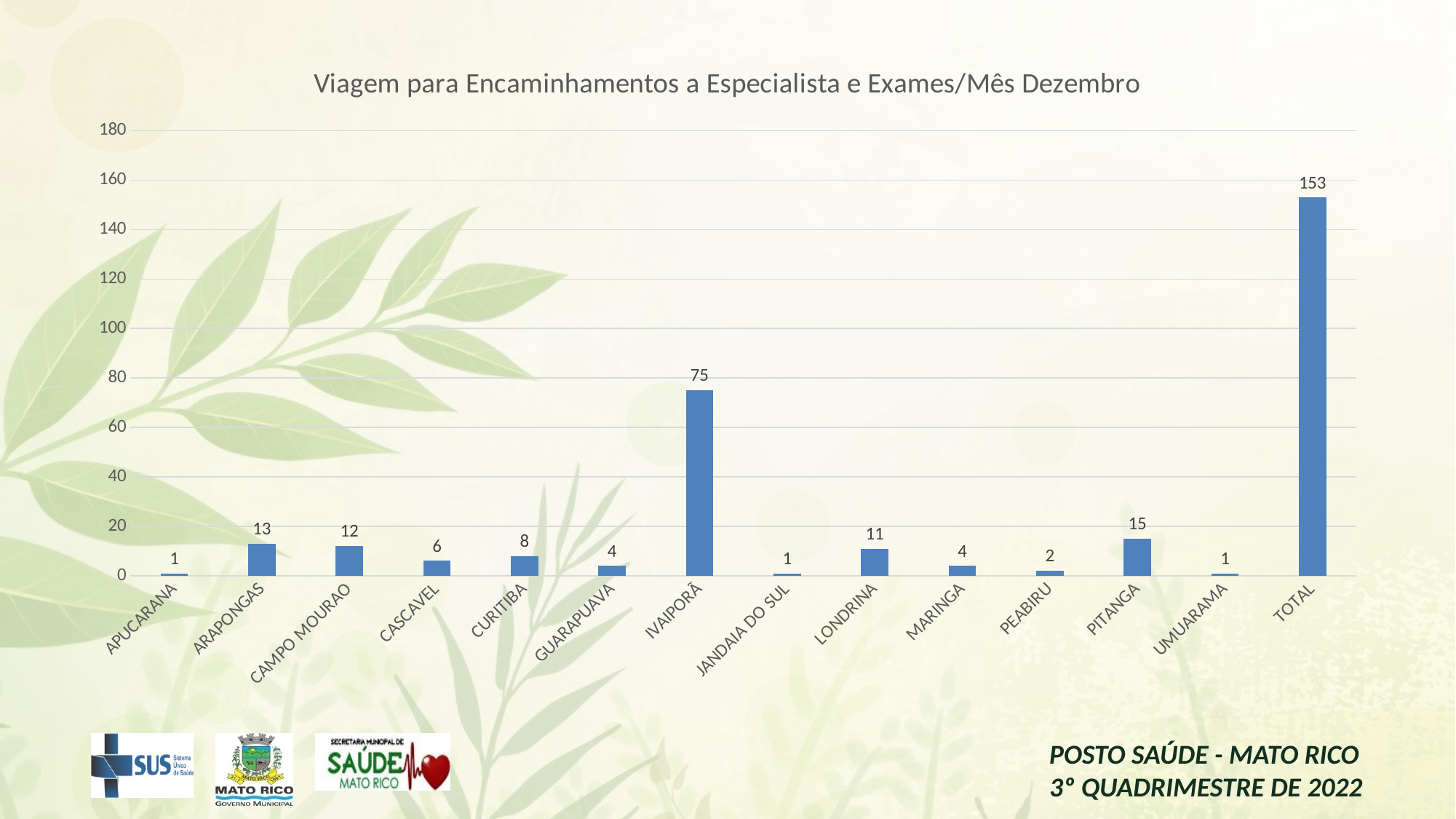
Is the value for IVAIPORÃ greater or less than 60? greater What is the title of the chart? Viagem para Encaminhamentos a Especialista e Exames/Mês Dezembro What kind of chart is shown on the slide? Bar chart What is the difference between the values for ARAPONGAS and CASCAVEL? 7 How many categories are shown on the x axis, including TOTAL? 14 Excluding the TOTAL bar, which city has the highest value? IVAIPORÃ Which cities have a value of 1? APUCARANA, JANDAIA DO SUL, UMUARAMA What is the value shown for TOTAL? 153 Which is larger, the value for LONDRINA or the value for CURITIBA? LONDRINA What is the value for IVAIPORÃ? 75 What is the value for CAMPO MOURAO? 12 What is the value for PITANGA? 15